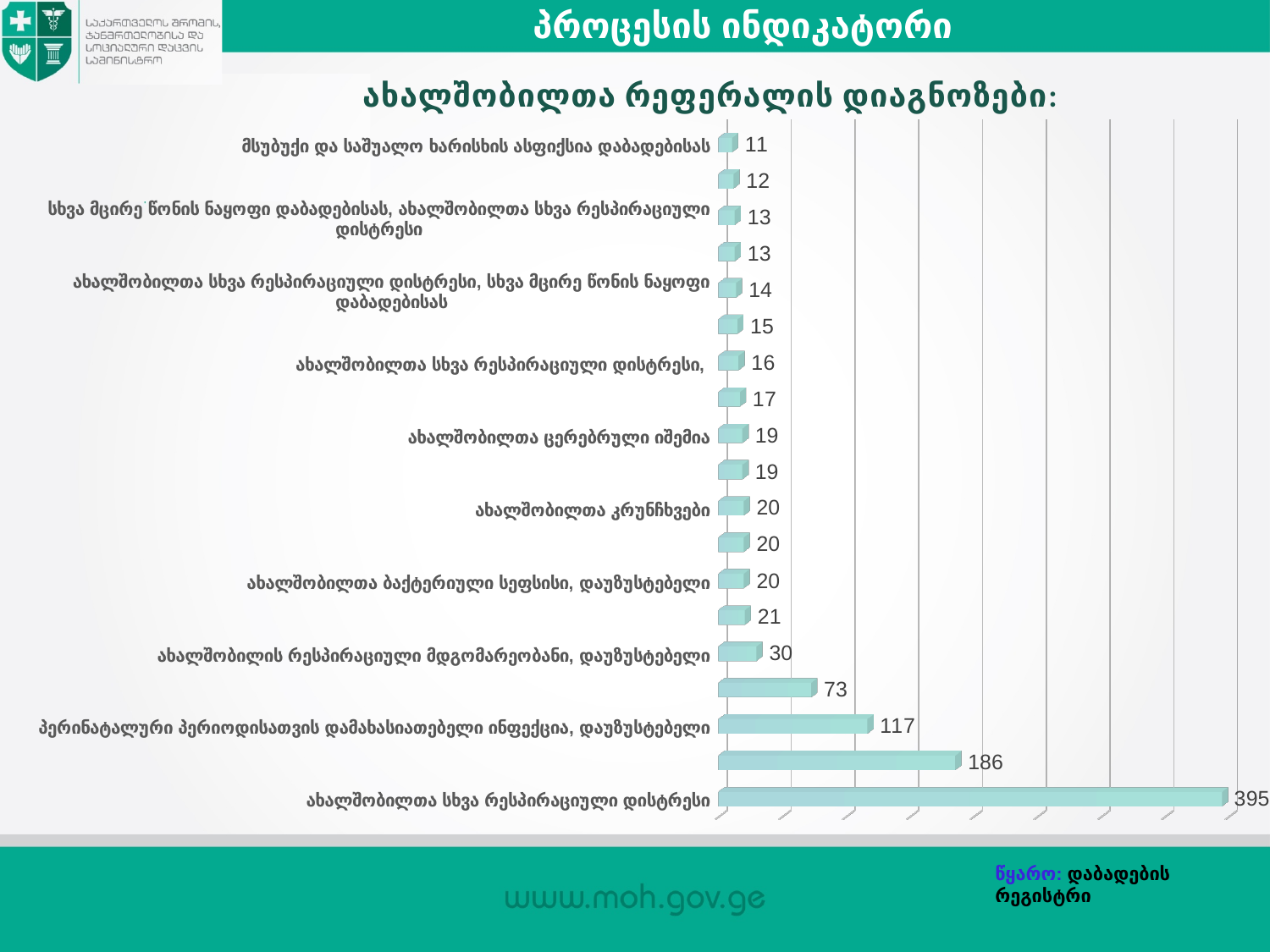
What is the value for ახალშობილთა ცერებრული იშემია? 19 Which category has the highest value? ახალშობილთა სხვა რესპირაციული დისტრესი What is the value for მსუბუქი და საშუალო ხარისხის ასფიქსია დაბადებისას? 11 What is the value for ახალშობილთა სხვა რესპირაციული დისტრესი (the bottom bar)? 395 What is the value for ახალშობილის რესპირაციული მდგომარეობანი, დაუზუსტებელი? 30 What is the value for პერინატალური პერიოდისათვის დამახასიათებელი ინფექცია, დაუზუსტებელი? 117 What is the title of the chart? ახალშობილთა რეფერალის დიაგნოზები: Which is larger: the value for ახალშობილთა კრუნჩხვები or the value for ახალშობილთა ცერებრული იშემია? ახალშობილთა კრუნჩხვები What type of chart is shown on the slide? bar chart Which category has the lowest value? მსუბუქი და საშუალო ხარისხის ასფიქსია დაბადებისას How many bars are plotted in the chart? 19 What is the difference between the value for ახალშობილთა სხვა რესპირაციული დისტრესი (395) and the value for პერინატალური პერიოდისათვის დამახასიათებელი ინფექცია, დაუზუსტებელი (117)? 278